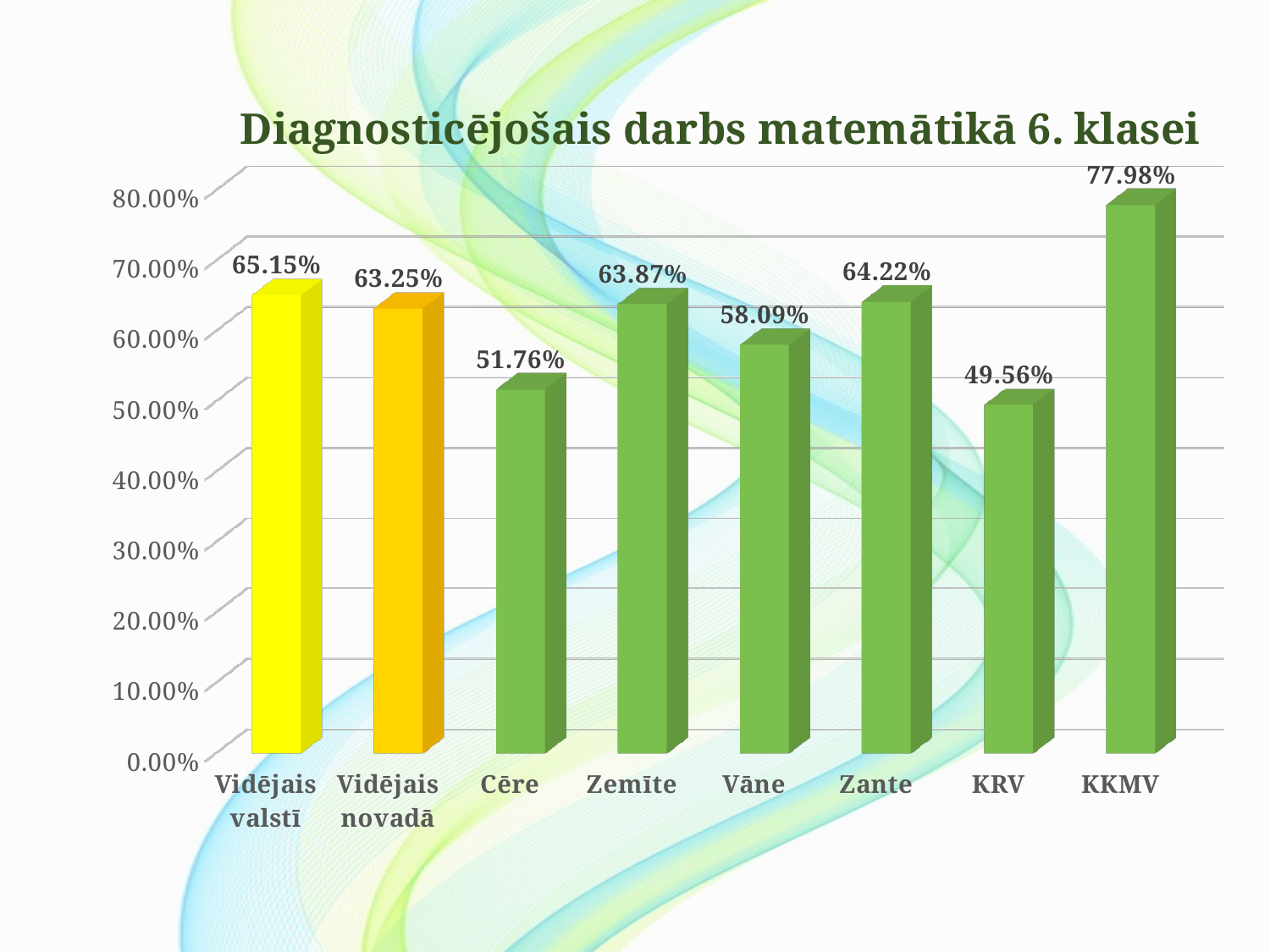
What is the value for Vidējais valstī? 65.15% Which is larger, the value for Zante or the value for Cēre? Zante How many categories are shown on the x axis? 8 What kind of chart is shown on the slide? bar chart What is the difference between the values for Vidējais valstī and Vidējais novadā? 1.90% Which category has the highest value? KKMV What is the difference between the values for KKMV and KRV? 28.42% Which category has the lowest value? KRV What is the title of the chart? Diagnosticējošais darbs matemātikā 6. klasei Is the value for Cēre greater or less than 60.00%? less What is the value for Vāne? 58.09% What is the value for KKMV? 77.98%